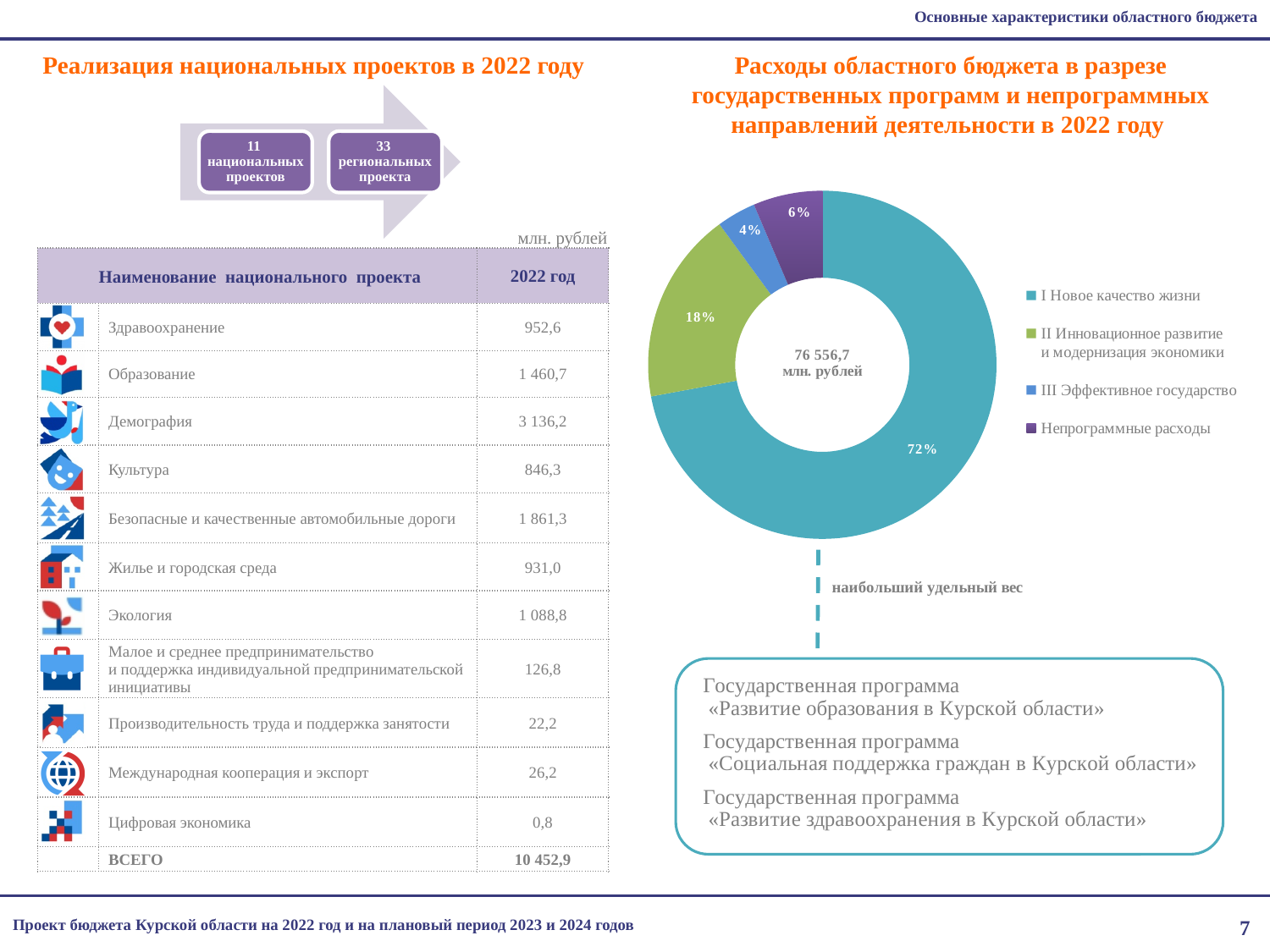
How many slices does the donut chart have? 4 Which category has the largest share in the donut chart? I Новое качество жизни What is the difference in percentage points between the shares of "I Новое качество жизни" and "II Инновационное развитие и модернизация экономики"? 54 What share of the donut chart does "Непрограммные расходы" take? 6% What share of the donut chart does "I Новое качество жизни" take? 72% What share of the donut chart does "II Инновационное развитие и модернизация экономики" take? 18% What kind of chart is shown on the right side of the slide? Donut (pie) chart Which has a larger share in the donut chart: "Непрограммные расходы" or "III Эффективное государство"? Непрограммные расходы Which category has the smallest share in the donut chart? III Эффективное государство How many entries does the legend of the donut chart list? 4 What total value is printed in the centre of the donut chart? 76 556,7 млн. рублей